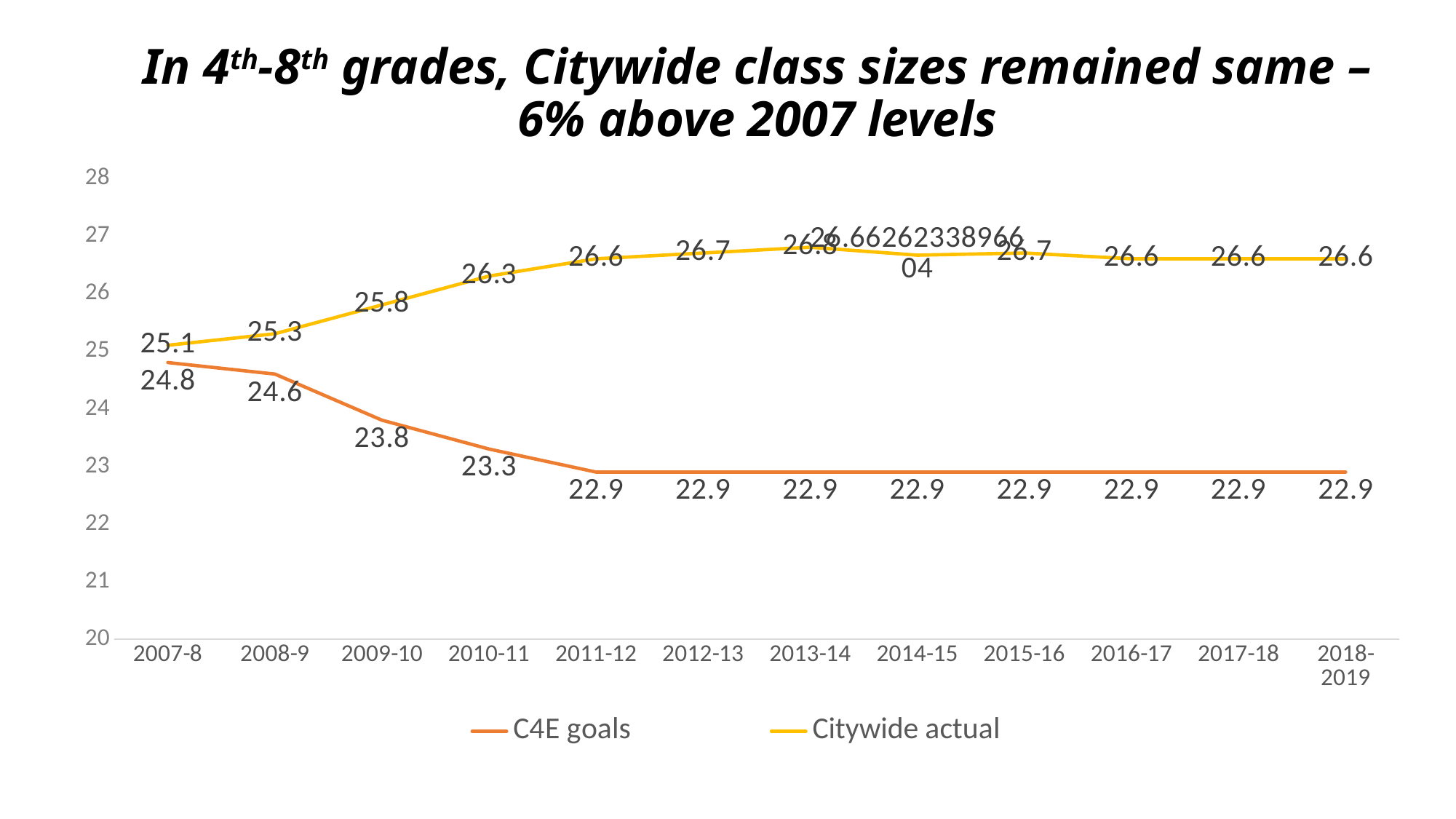
How many school years are shown on the x axis? 12 Which school year has the lowest Citywide actual value? 2007-8 Which series has the higher value in 2016-17, C4E goals or Citywide actual? Citywide actual What is the C4E goals value for 2018-2019? 22.9 How many series does the legend list? 2 What type of chart is shown on the slide? line chart What is the difference between the Citywide actual and C4E goals values in 2012-13? 3.8 Is the Citywide actual value for 2017-18 greater or less than 26? greater What is the Citywide actual value for 2007-8? 25.1 Does the C4E goals series rise or fall from 2007-8 to 2011-12? fall What is the Citywide actual value for 2010-11? 26.3 What is the C4E goals value for 2009-10? 23.8